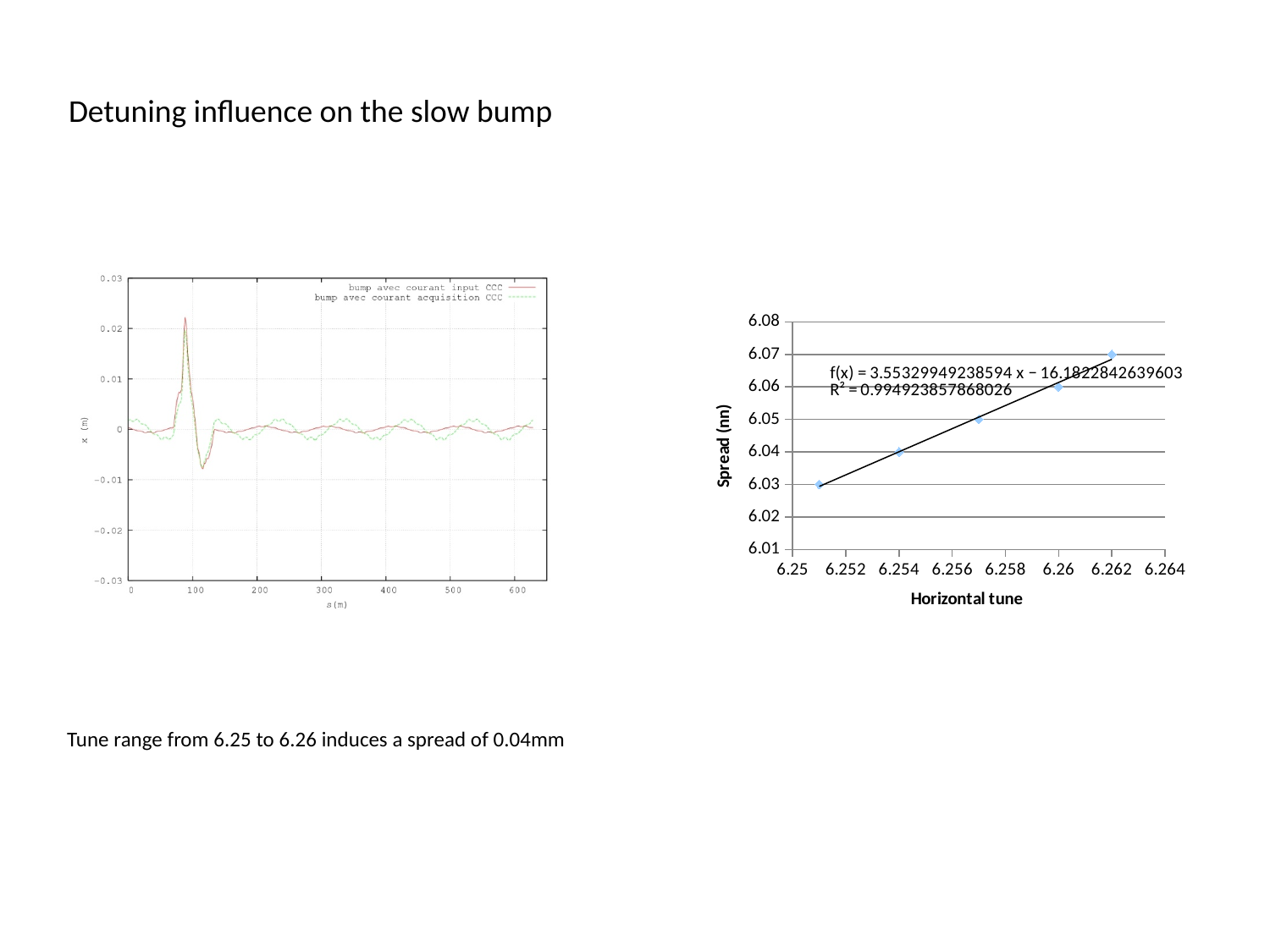
What kind of chart is the chart on the right of the slide (Spread vs Horizontal tune)? scatter chart In the chart on the right, how many data points are plotted? 5 In the chart on the right, do the spread values rise or fall as the horizontal tune increases? rise In the chart on the right, what is the equation of the fitted line shown on the chart? f(x) = 3.55329949238594 x − 16.1822842639603 In the chart on the right, which point has the highest spread value: the one at horizontal tune 6.254 or the one at 6.262? 6.262 In the chart on the right, is the spread value of the leftmost point greater or less than 6.04? less In the chart on the right, what is the label of the x axis? Horizontal tune How many series does the legend of the chart on the left of the slide list? 2 In the chart on the right, what R² value is shown for the fitted line? 0.994923857868026 In the chart on the right, is the spread value of the point at horizontal tune 6.26 greater or less than 6.05? greater In the chart on the left, is the peak value of the bump greater or less than 0.02? greater In the chart on the right, what is the label of the y axis? Spread (nn)